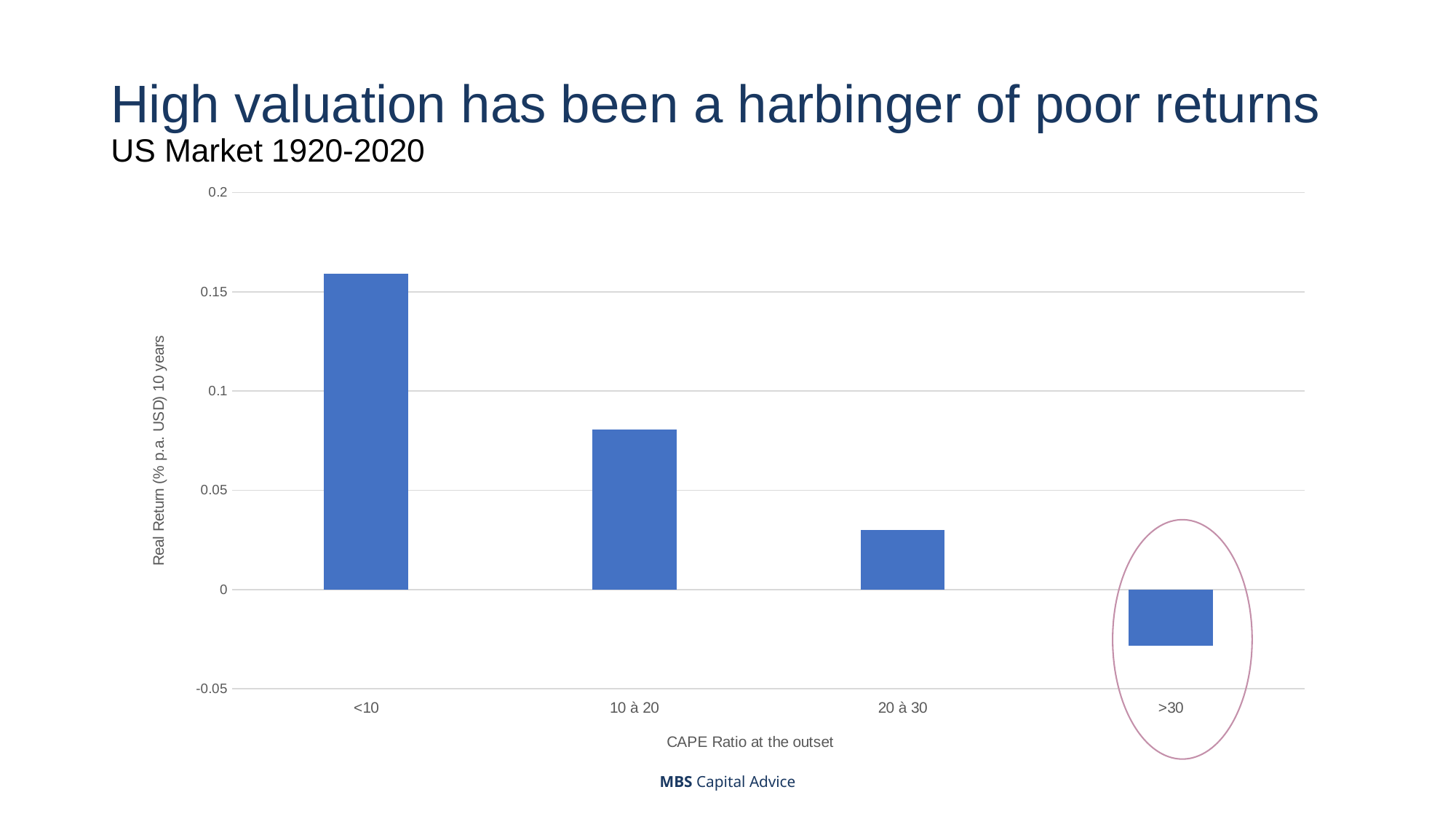
Is the value for the <10 category greater or less than 0.1? greater Which has the larger real return, the <10 category or the 10 à 20 category? <10 Which CAPE ratio category has the lowest real return? >30 How many CAPE ratio categories are plotted on the chart? 4 What is the title of the x axis? CAPE Ratio at the outset Do the real returns rise or fall as the CAPE ratio category increases along the x axis? fall Is the value for the >30 category greater or less than 0? less What kind of chart is shown on the slide? bar chart Is the value for the 20 à 30 category greater or less than 0.05? less Which CAPE ratio category has the highest real return? <10 Which category's bar is circled on the chart? >30